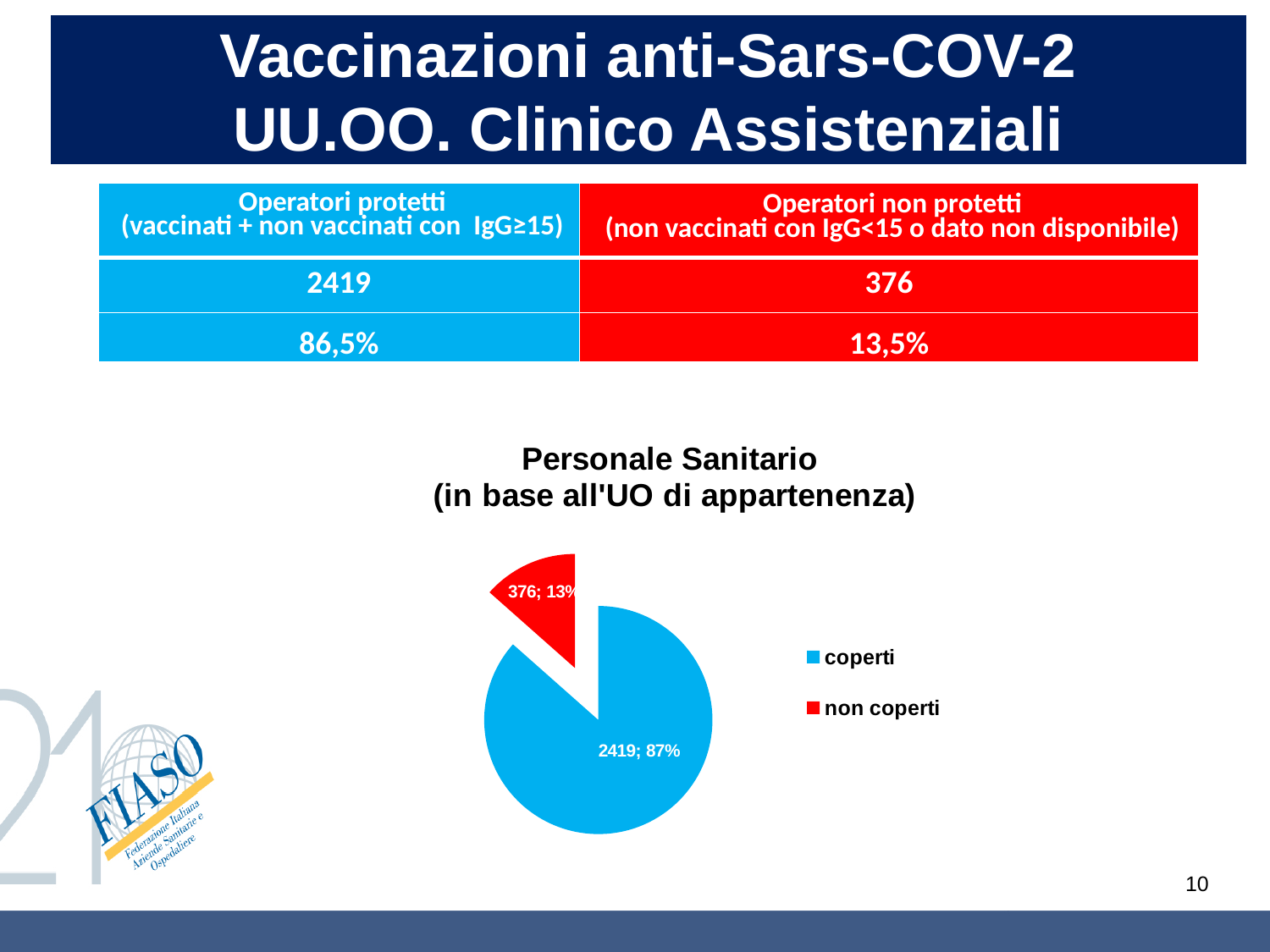
Which slice is the largest in the pie chart? coperti What share of the pie does 'coperti' represent? 87% How many entries does the legend list? 2 Which slice is the smallest in the pie chart? non coperti What kind of chart is shown on the slide? pie chart What is the value for 'coperti' in the pie chart? 2419 What is the difference between the 'coperti' and 'non coperti' values? 2043 What is the title of the chart? Personale Sanitario (in base all'UO di appartenenza) How many slices does the pie chart have? 2 Which colour represents 'non coperti' in the pie chart? red What share of the pie does 'non coperti' represent? 13% What is the value for 'non coperti' in the pie chart? 376